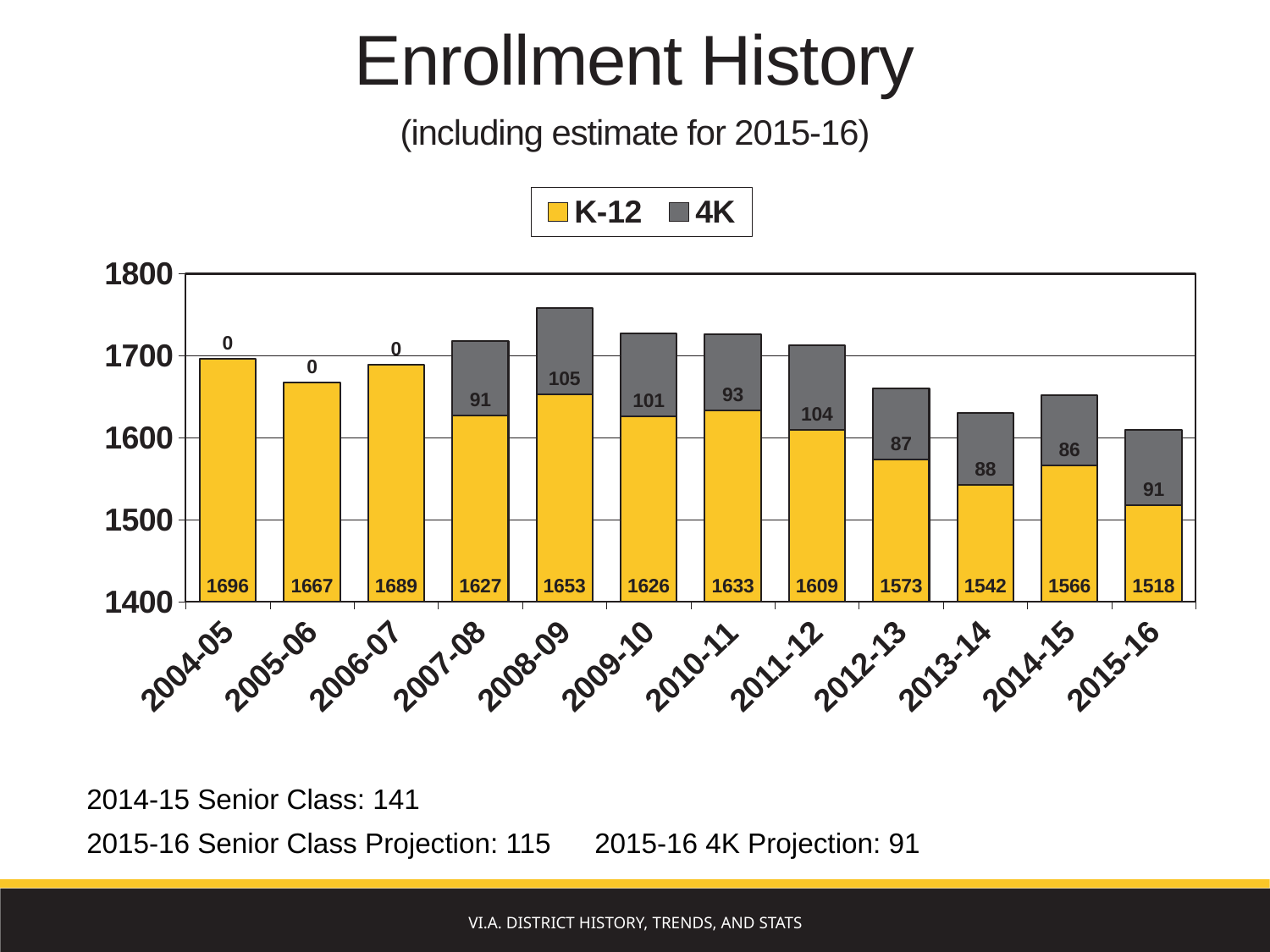
How many school years are shown on the x axis? 12 What is the total of the stacked bar for 2007-08 (K-12 plus 4K)? 1718 What kind of chart is shown on the slide? Stacked bar chart What is the difference between the K-12 values for 2004-05 and 2015-16? 178 What is the 4K value for 2011-12? 104 Which is larger, the K-12 value for 2012-13 or for 2014-15? 2014-15 Do the K-12 values generally rise or fall from 2004-05 to 2015-16? Fall How many series does the legend list? 2 Which year has the highest 4K value? 2008-09 Which year has the highest K-12 enrollment? 2004-05 What is the K-12 enrollment value for 2008-09? 1653 Which year has the lowest K-12 enrollment? 2015-16